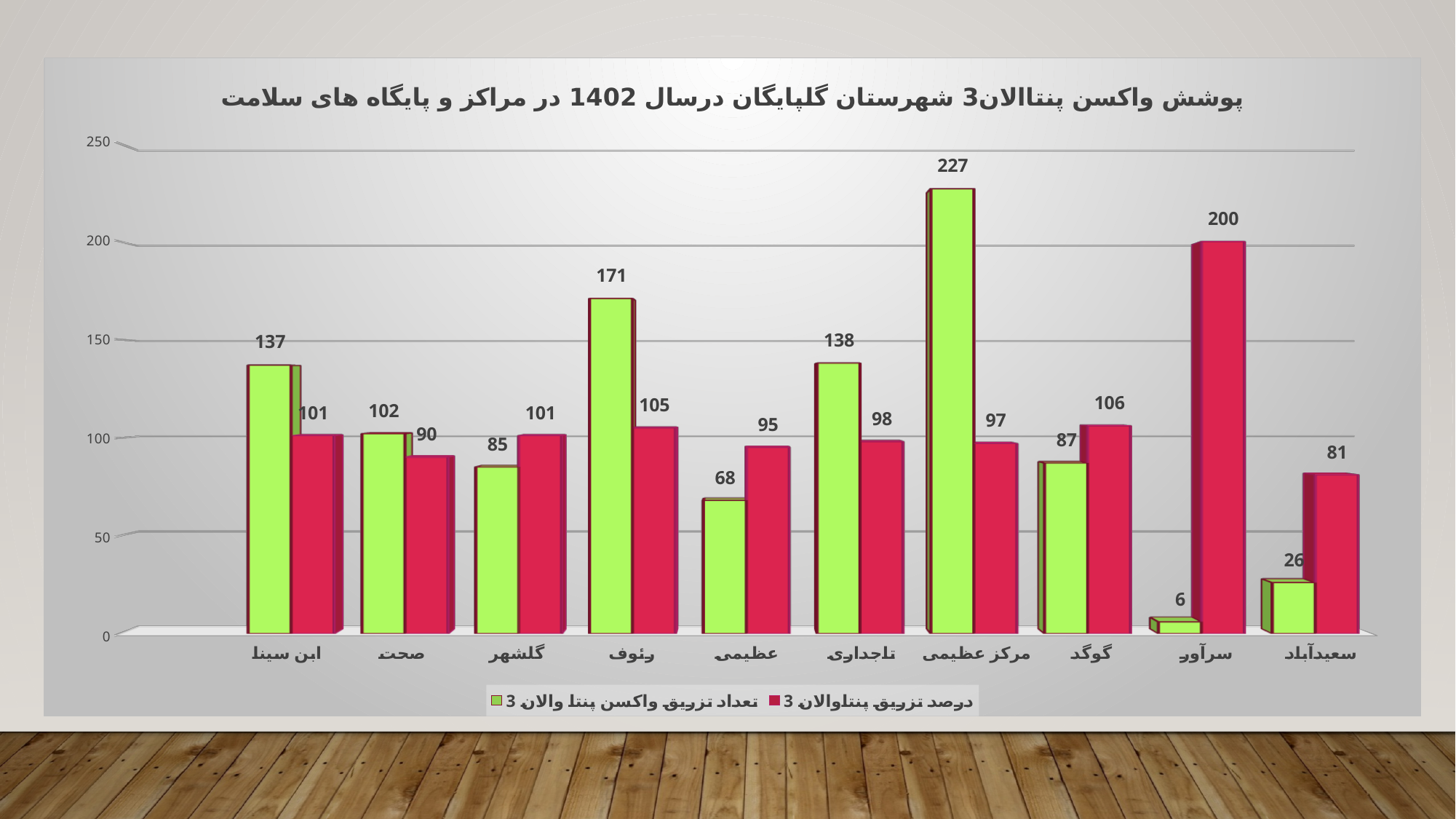
For گلشهر, which is larger: the green series value or the red series value? the red series (101) Which category has the lowest value in the green series (تعداد تزریق واکسن پنتاوالان 3)? سرآور Which category has the highest value in the green series (تعداد تزریق واکسن پنتاوالان 3)? مرکز عظیمی What is the difference between the green and red values for ابن سینا? 36 Which category has the highest value in the red series (درصد تزریق پنتاوالان 3)? سرآور What is the value of the red series (درصد تزریق پنتاوالان 3) for سعیدآباد? 81 How many series does the legend list? 2 What kind of chart is shown on the slide? bar chart What is the value of the green series (تعداد تزریق واکسن پنتاوالان 3) for رئوف? 171 What is the value of the red series (درصد تزریق پنتاوالان 3) for سرآور? 200 How many categories are shown on the x axis? 10 What is the value of the green series (تعداد تزریق واکسن پنتاوالان 3) for مرکز عظیمی? 227